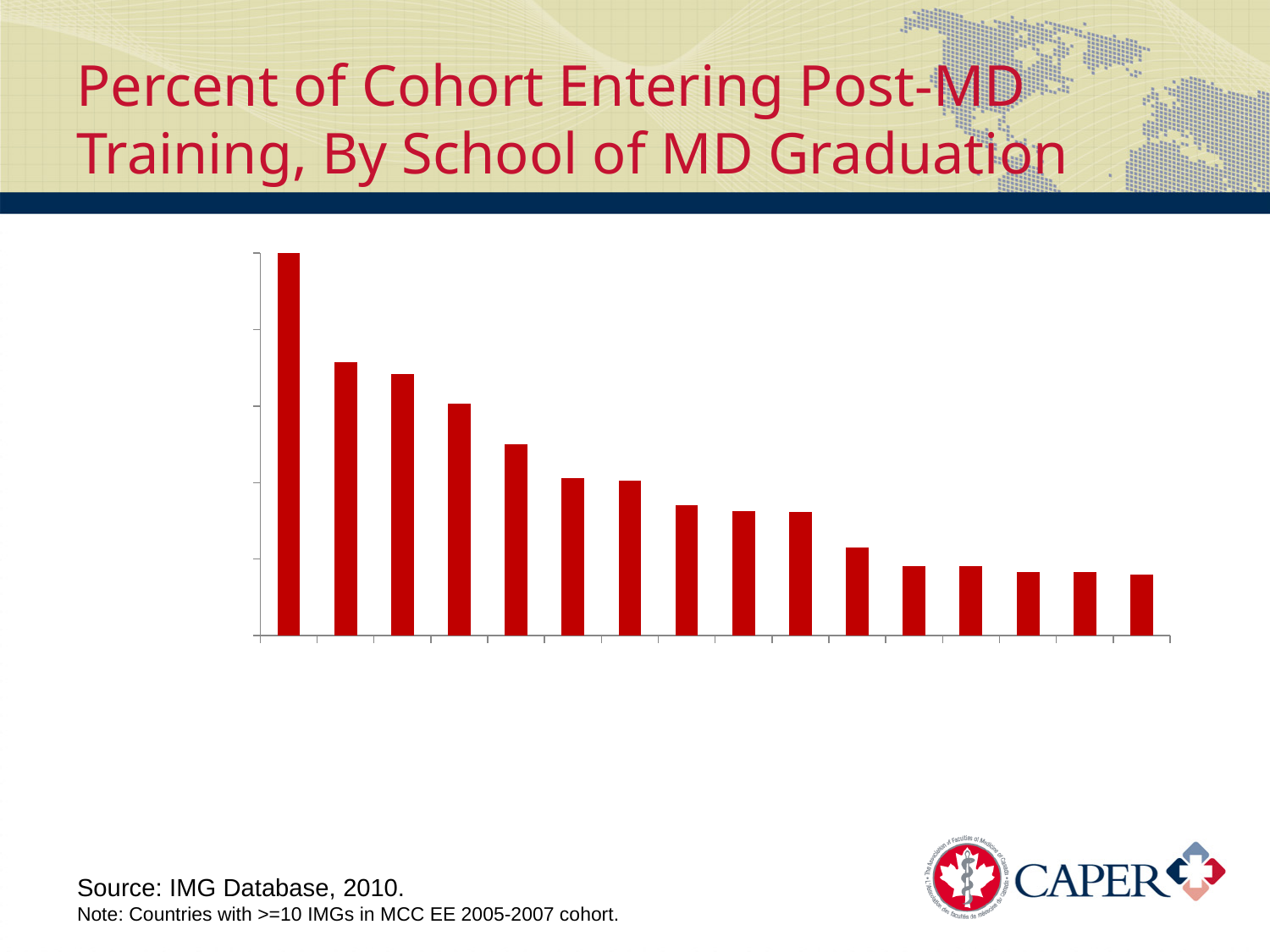
Which is taller, the first bar from the left or the second bar from the left? the first bar Do the bar values rise or fall from left to right across the chart? fall Which is taller, the fourth bar from the left or the tenth bar from the left? the fourth bar What is the title of the slide containing the chart? Percent of Cohort Entering Post-MD Training, By School of MD Graduation What kind of chart is shown on the slide? bar chart Which bar is the tallest in the chart? the leftmost (first) bar How many bars are plotted in the chart? 16 What colour are the bars in the chart? red